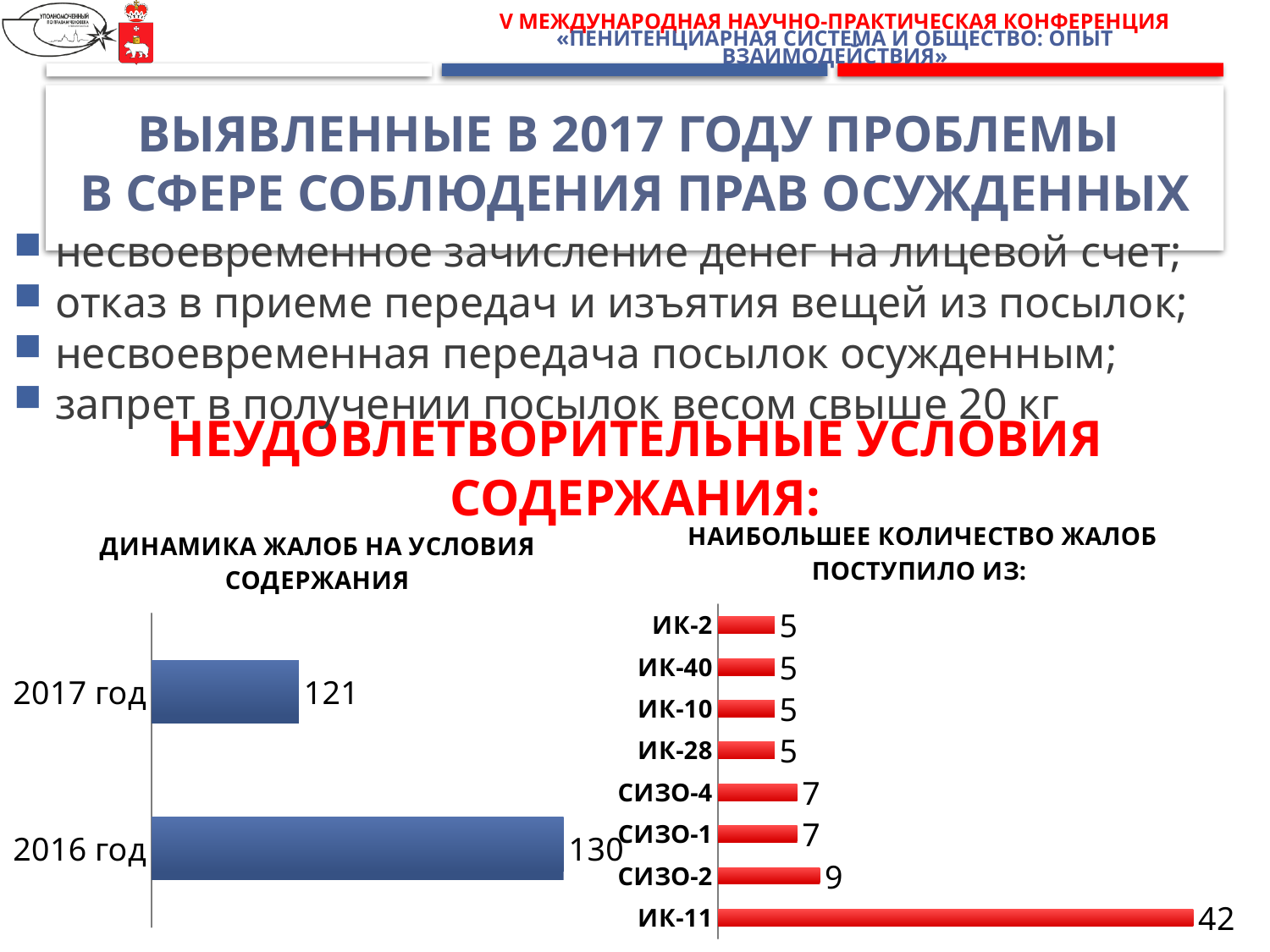
In the left chart 'ДИНАМИКА ЖАЛОБ НА УСЛОВИЯ СОДЕРЖАНИЯ', which year has the larger value, 2016 год or 2017 год? 2016 год In the left chart 'ДИНАМИКА ЖАЛОБ НА УСЛОВИЯ СОДЕРЖАНИЯ', what is the difference between the 2016 год and 2017 год values? 9 In the right chart 'НАИБОЛЬШЕЕ КОЛИЧЕСТВО ЖАЛОБ ПОСТУПИЛО ИЗ:', how many categories are shown? 8 What kind of chart is the left chart 'ДИНАМИКА ЖАЛОБ НА УСЛОВИЯ СОДЕРЖАНИЯ'? bar chart In the right chart 'НАИБОЛЬШЕЕ КОЛИЧЕСТВО ЖАЛОБ ПОСТУПИЛО ИЗ:', what is the value for ИК-11? 42 In the right chart 'НАИБОЛЬШЕЕ КОЛИЧЕСТВО ЖАЛОБ ПОСТУПИЛО ИЗ:', what is the value for СИЗО-4? 7 In the right chart 'НАИБОЛЬШЕЕ КОЛИЧЕСТВО ЖАЛОБ ПОСТУПИЛО ИЗ:', what is the value for СИЗО-2? 9 In the right chart 'НАИБОЛЬШЕЕ КОЛИЧЕСТВО ЖАЛОБ ПОСТУПИЛО ИЗ:', which is larger, the value for СИЗО-1 or the value for ИК-28? СИЗО-1 In the right chart 'НАИБОЛЬШЕЕ КОЛИЧЕСТВО ЖАЛОБ ПОСТУПИЛО ИЗ:', what is the difference between the values for ИК-11 and СИЗО-2? 33 In the left chart 'ДИНАМИКА ЖАЛОБ НА УСЛОВИЯ СОДЕРЖАНИЯ', what is the value for 2017 год? 121 In the right chart 'НАИБОЛЬШЕЕ КОЛИЧЕСТВО ЖАЛОБ ПОСТУПИЛО ИЗ:', which category has the highest value? ИК-11 In the left chart 'ДИНАМИКА ЖАЛОБ НА УСЛОВИЯ СОДЕРЖАНИЯ', what is the value for 2016 год? 130